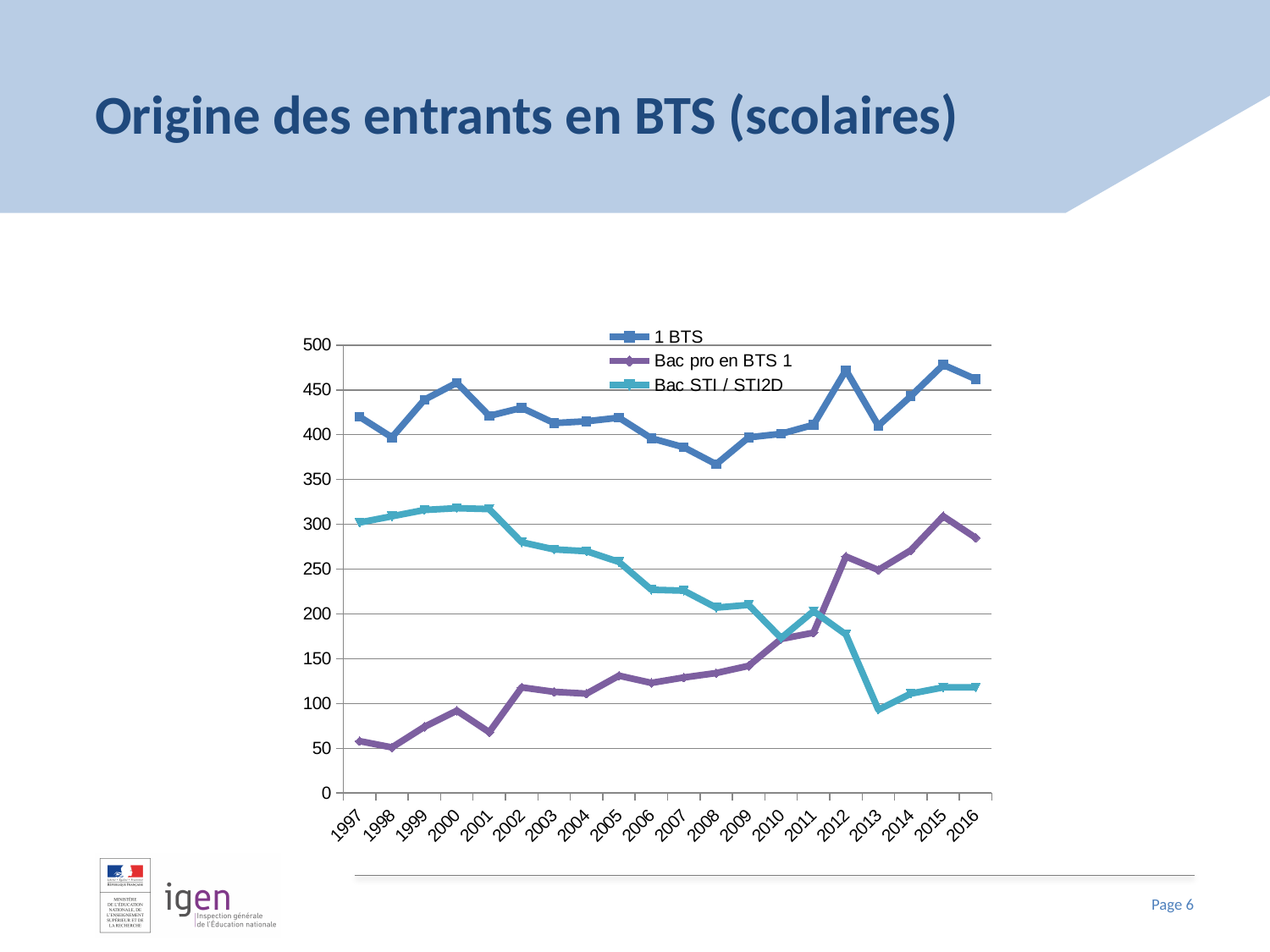
Does the Bac STI / STI2D series rise or fall overall from 1997 to 2016? fall Which series is shown in the light blue (cyan) line? Bac STI / STI2D How many years are plotted along the x axis? 20 What is the title of the slide containing the chart? Origine des entrants en BTS (scolaires) Is the value for Bac STI / STI2D in 2016 greater or less than 150? less How many series does the legend list? 3 In which year is the Bac STI / STI2D series at its lowest? 2013 Is the value for Bac pro en BTS 1 in 1997 greater or less than 100? less What kind of chart is shown on the slide? line chart In which year is the Bac pro en BTS 1 series at its highest? 2015 Is the value for 1 BTS in 2015 greater or less than 450? greater